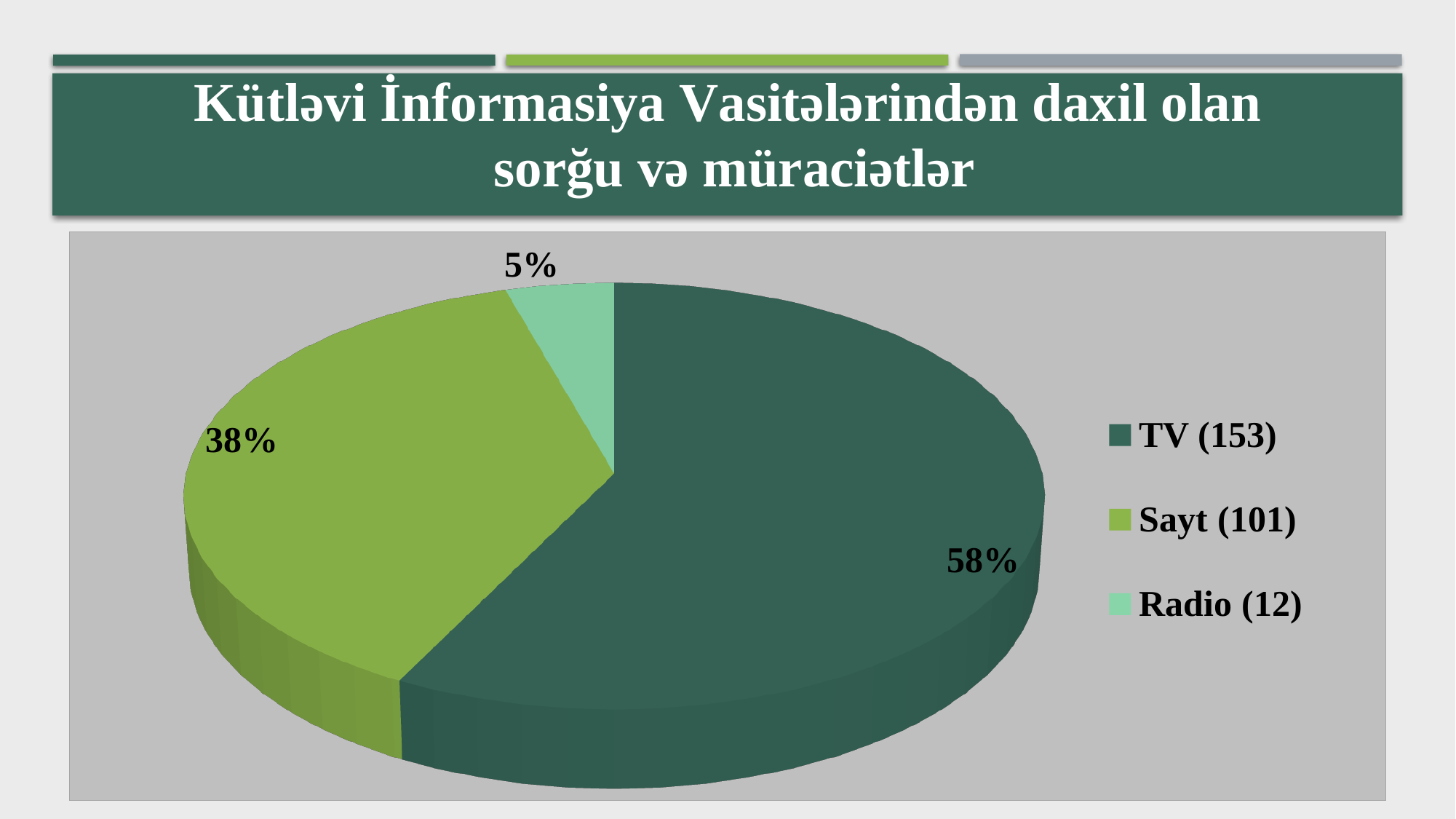
What is the difference in percentage points between the Sayt slice and the Radio slice? 33% What colour is the slice for Sayt (101)? Light green How many categories are shown in the pie chart? 3 Which category has the largest slice of the pie? TV (153) What percentage share of the pie does Sayt (101) have? 38% Which slice is larger, Sayt or Radio? Sayt What is the difference in percentage points between the TV slice and the Sayt slice? 20% What percentage share of the pie does Radio (12) have? 5% What kind of chart is shown on the slide? Pie chart Which category has the smallest slice of the pie? Radio (12) What is the title of the slide containing the chart? Kütləvi İnformasiya Vasitələrindən daxil olan sorğu və müraciətlər What percentage share of the pie does TV (153) have? 58%